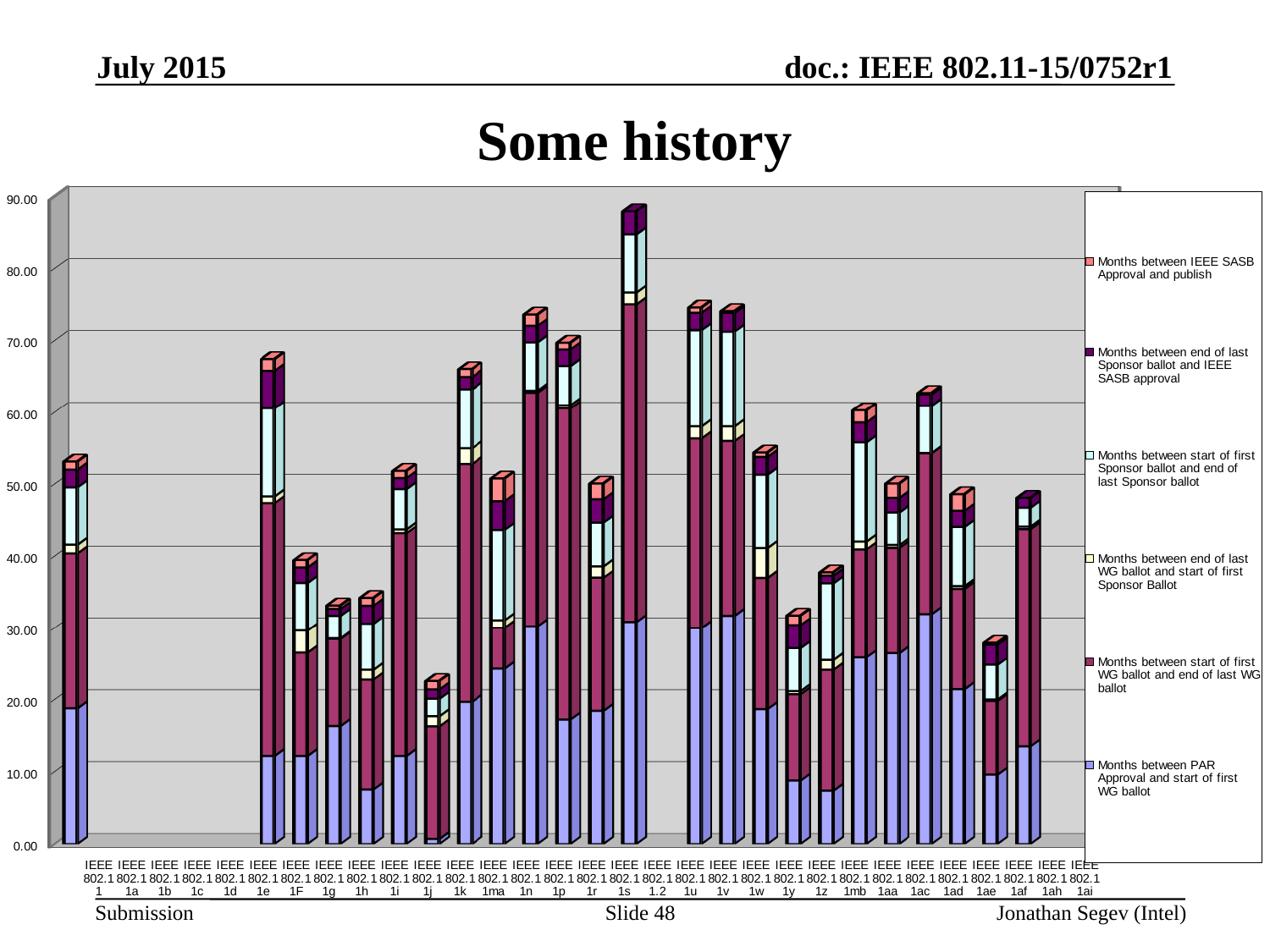
Is the total for IEEE 802.11j greater or less than 30? less What kind of chart is shown on the slide? Stacked bar chart How many series does the legend list? 6 Is the total for IEEE 802.11e greater or less than 60? greater Is the total for IEEE 802.11n greater or less than 70? greater Which category has the tallest stacked bar? IEEE 802.11s Which has the larger total, IEEE 802.11e or IEEE 802.11j? IEEE 802.11e How many categories are shown along the x axis? 31 What is the title of the chart slide? Some history Which legend entry corresponds to the bottom segment of each stacked bar? Months between PAR Approval and start of first WG ballot Among the categories with a visible bar, which has the lowest total? IEEE 802.11j